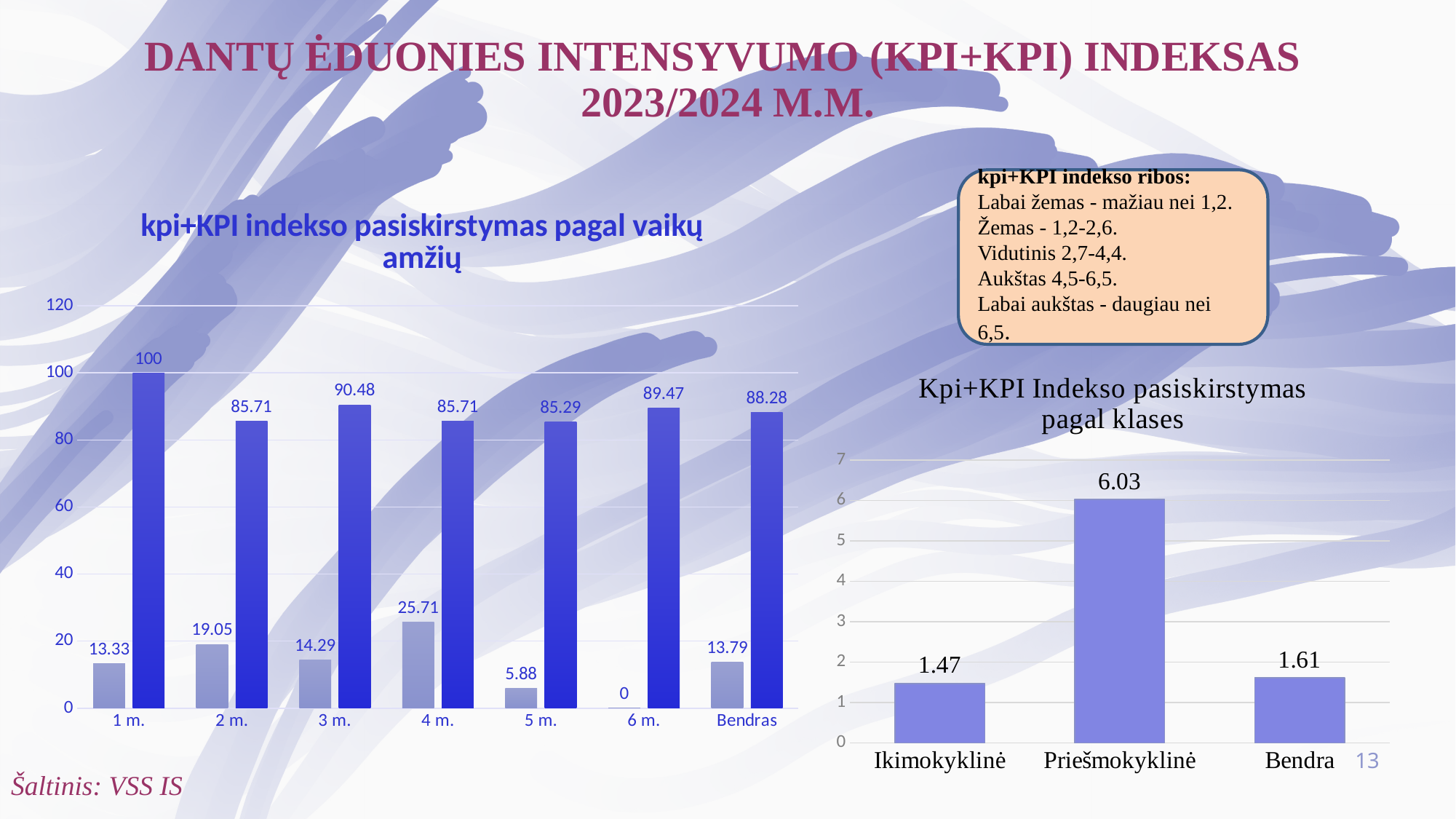
In the chart 'Kpi+KPI Indekso pasiskirstymas pagal klases', what is the value for Priešmokyklinė? 6.03 In the chart 'Kpi+KPI Indekso pasiskirstymas pagal klases', what is the value for Ikimokyklinė? 1.47 In the chart 'Kpi+KPI Indekso pasiskirstymas pagal klases', what is the difference between the values for Priešmokyklinė and Bendra? 4.42 In the chart 'kpi+KPI indekso pasiskirstymas pagal vaikų amžių', what is the value of the taller dark blue bar for 3 m.? 90.48 In the chart 'kpi+KPI indekso pasiskirstymas pagal vaikų amžių', which category has the lowest light bar? 6 m. In the chart 'Kpi+KPI Indekso pasiskirstymas pagal klases', how many categories are shown? 3 In the chart 'Kpi+KPI Indekso pasiskirstymas pagal klases', which category has the lowest value? Ikimokyklinė What type of chart is 'kpi+KPI indekso pasiskirstymas pagal vaikų amžių'? Bar chart In the chart 'kpi+KPI indekso pasiskirstymas pagal vaikų amžių', which category has the highest dark blue bar? 1 m. In the chart 'kpi+KPI indekso pasiskirstymas pagal vaikų amžių', what is the value of the shorter light bar for 4 m.? 25.71 In the chart 'kpi+KPI indekso pasiskirstymas pagal vaikų amžių', how many categories are shown on the x axis? 7 In the chart 'Kpi+KPI Indekso pasiskirstymas pagal klases', which category has the highest value? Priešmokyklinė